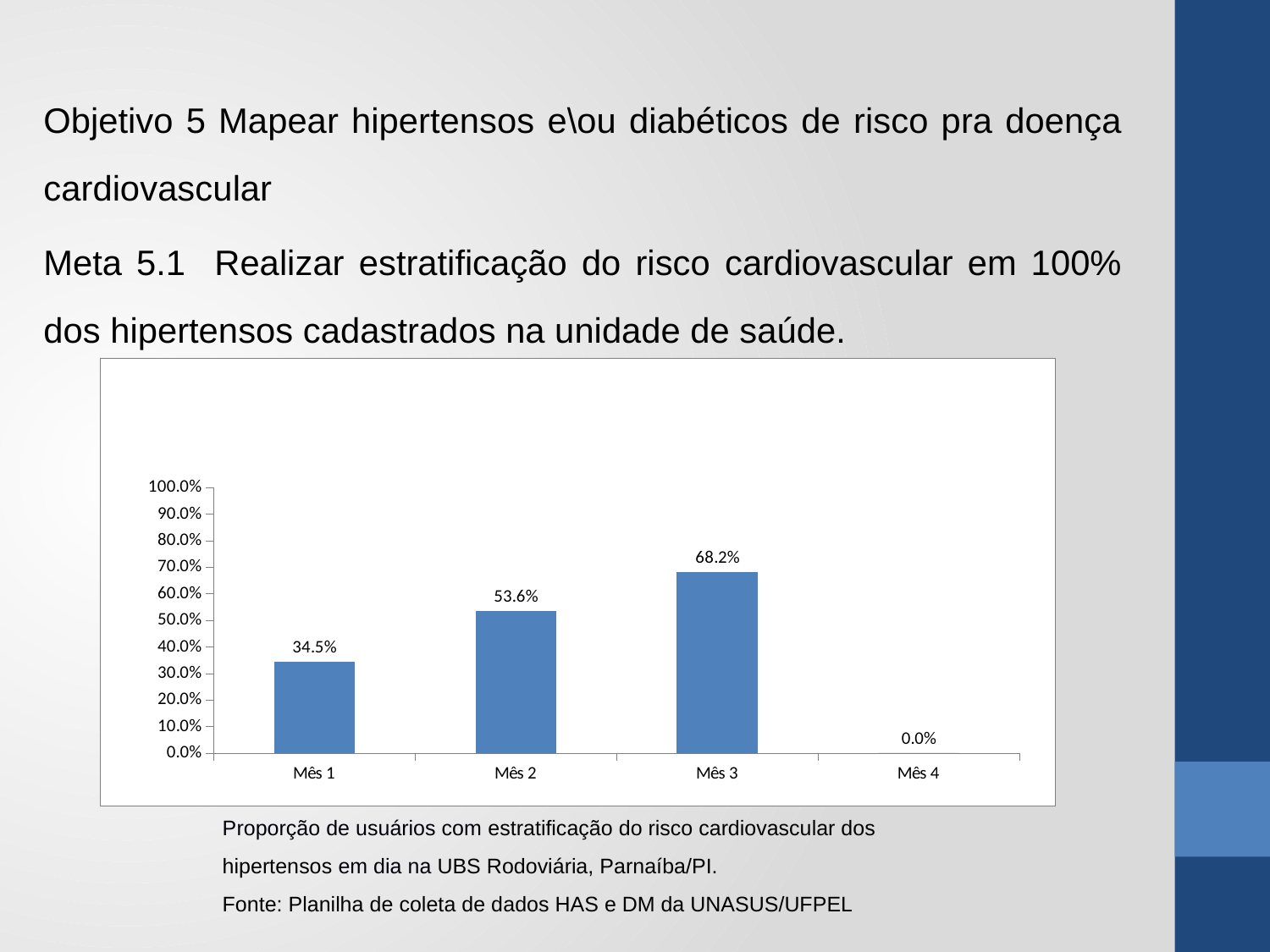
What kind of chart is shown on the slide? Bar chart What is the value for Mês 1? 34.5% Which month has the highest value? Mês 3 How many months are shown on the x axis? 4 What is the difference between the values for Mês 2 and Mês 1? 19.1% What is the value for Mês 2? 53.6% Which month has the lowest value? Mês 4 Which is larger, the value for Mês 2 or the value for Mês 3? Mês 3 Is the value for Mês 2 greater or less than 50.0%? greater What is the value for Mês 4? 0.0% What is the value for Mês 3? 68.2% What is the difference between the values for Mês 3 and Mês 1? 33.7%